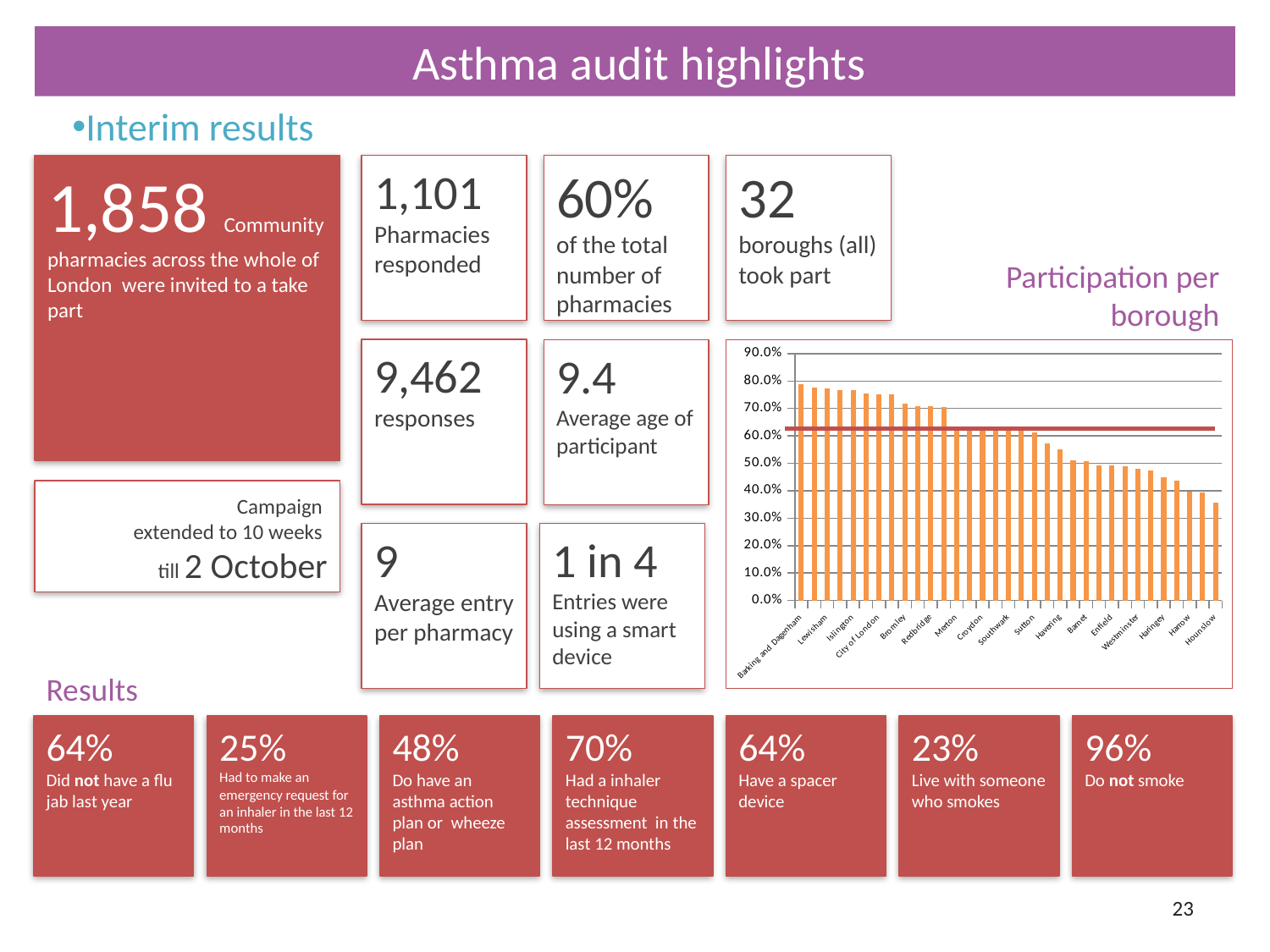
In the 'Participation per borough' chart, is the value for Hounslow greater or less than 40.0%? less In the 'Participation per borough' chart, which borough has the highest participation? Barking and Dagenham In the 'Participation per borough' chart, which has the larger value, Lewisham or Harrow? Lewisham In the 'Participation per borough' chart, is the value for Croydon greater or less than 50.0%? greater In the 'Participation per borough' chart, do the values rise or fall from left to right along the x axis? fall In the 'Participation per borough' chart, is the value for Harrow greater or less than 50.0%? less In the 'Participation per borough' chart, which borough has the lowest participation? Hounslow What is the highest value shown on the y axis of the 'Participation per borough' chart? 90.0% In the 'Participation per borough' chart, which has the larger value, Hounslow or Bromley? Bromley What kind of chart is the 'Participation per borough' chart? bar chart